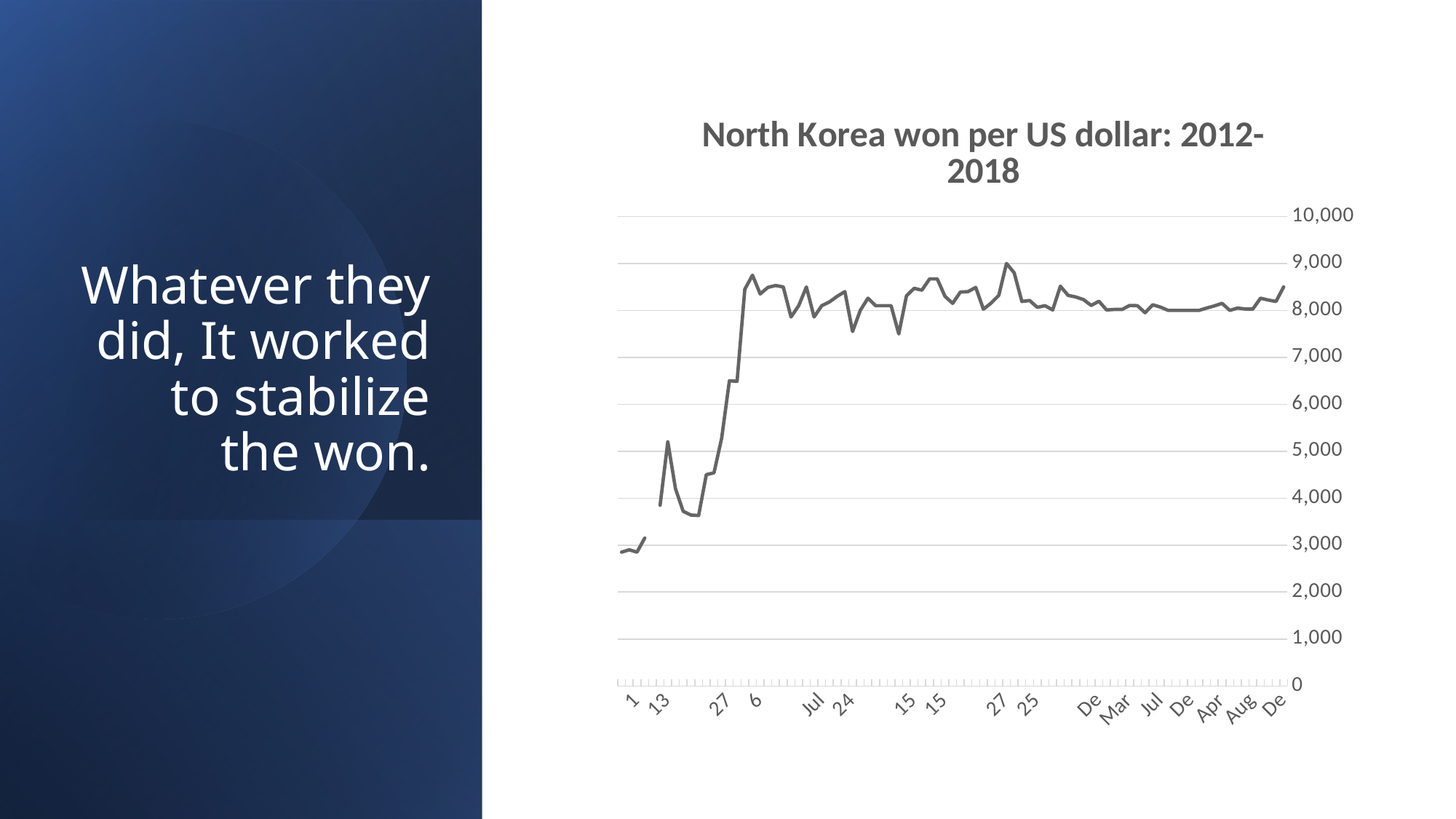
Is the lowest value on the line greater or less than 5,000? less What is the highest value shown on the vertical axis of the chart? 10,000 Is the value at the last point of the line (labelled De) greater or less than 8,000? greater What is the title of the chart? North Korea won per US dollar: 2012-2018 Is the value at the point labelled 6 greater or less than 7,000? greater Overall, do the values in the chart rise or fall from the start of the x axis to the end? rise What kind of chart is shown on the slide? line chart Which is larger, the value at the first point (labelled 1) or the value at the last point (labelled De)? the last point (De)